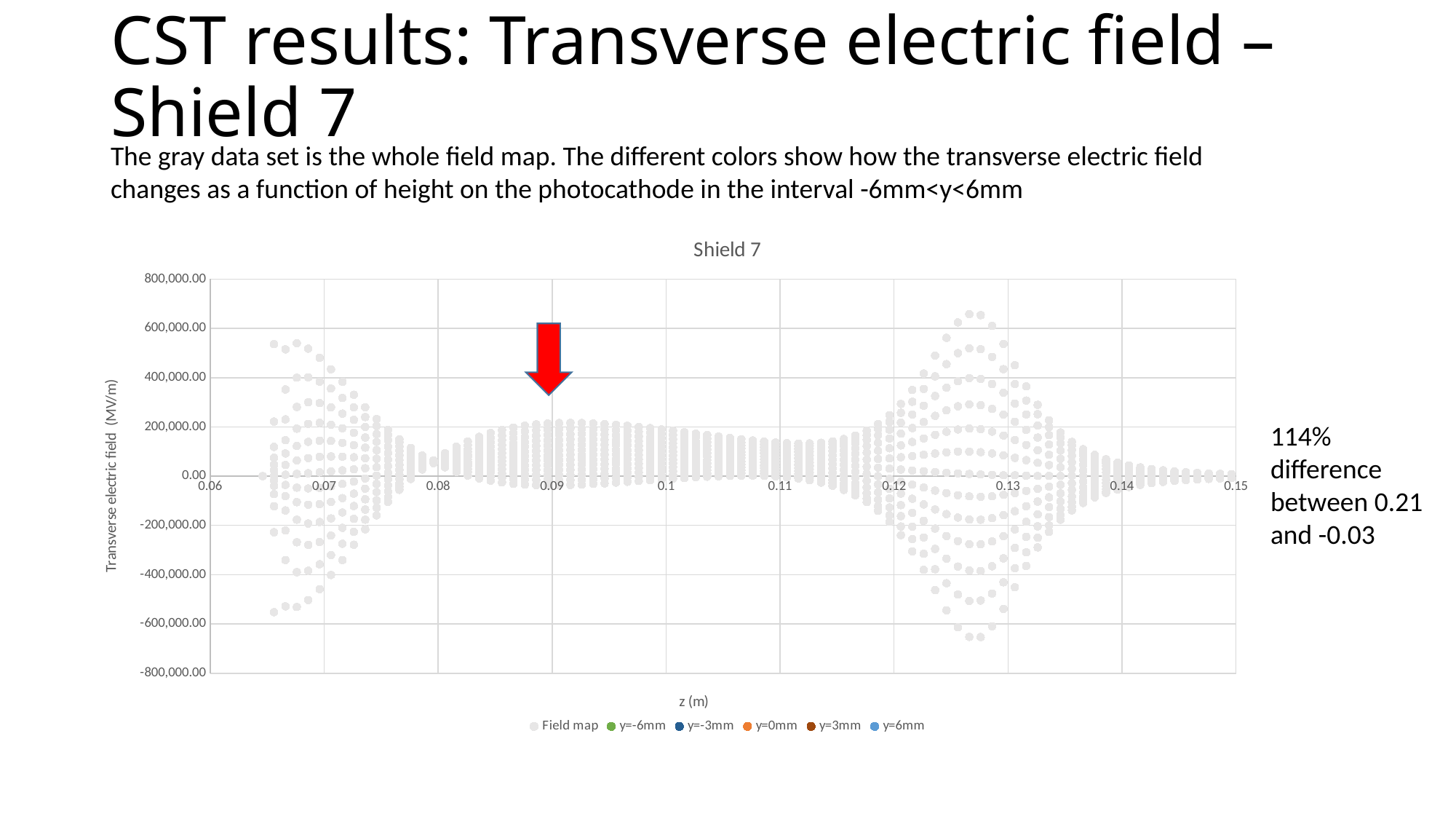
Is the highest Field map value near z = 0.13 greater or less than 600,000.00? greater What is the title of the chart? Shield 7 Is the lowest Field map value near z = 0.13 greater or less than -600,000.00? less Which region has the larger peak Field map value: around z = 0.07 or around z = 0.13? around z = 0.13 Is the highest Field map value near z = 0.145 greater or less than 200,000.00? less What is the label of the x axis of the chart? z (m) What kind of chart is shown on the slide? scatter chart How many series does the legend of the Shield 7 chart list? 6